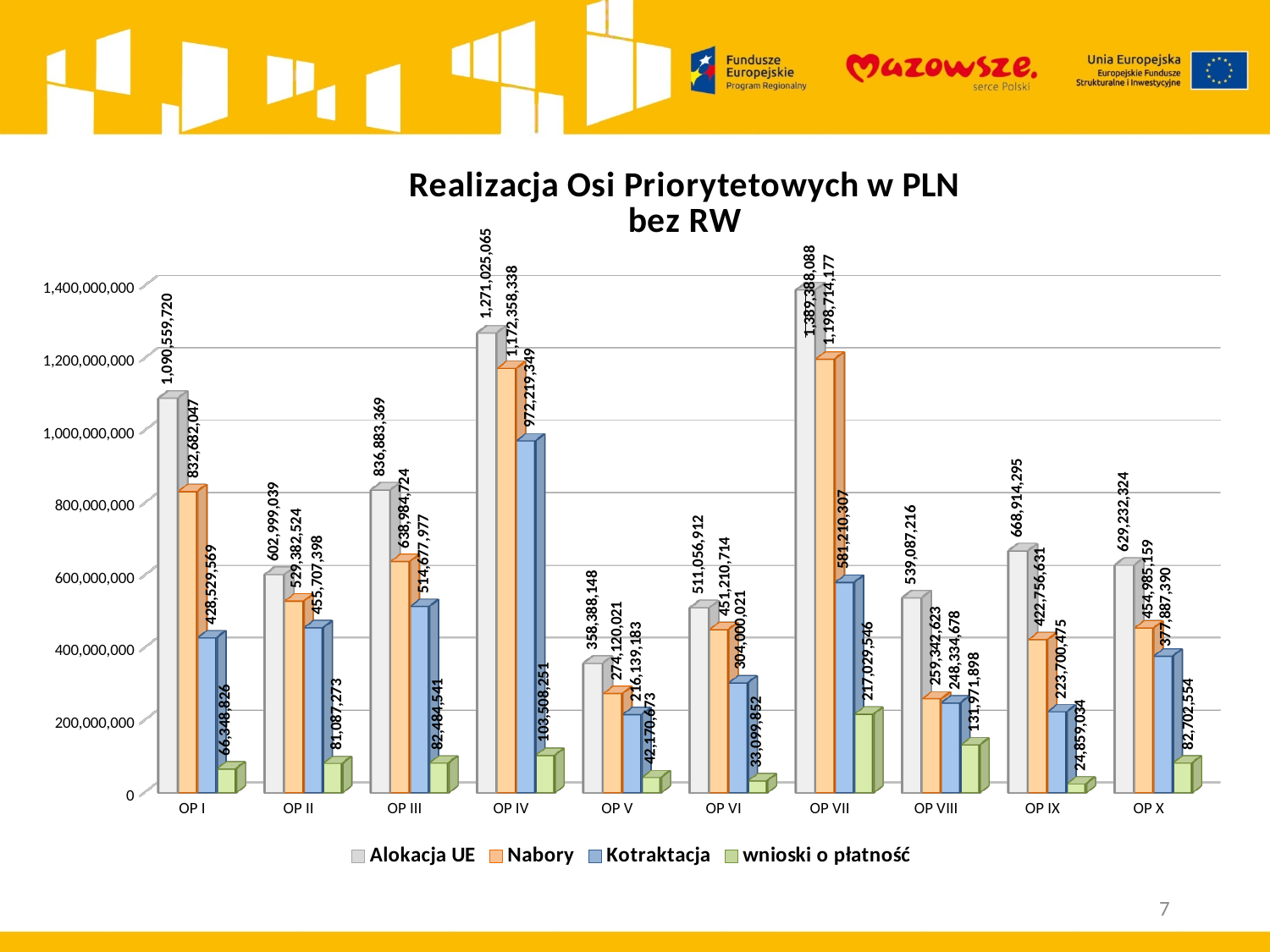
Is the Kotraktacja value for OP IV greater or less than 1,000,000,000? less What is the Nabory value for OP VI? 451,210,714 How many categories are shown on the x axis? 10 Which category has the lowest wnioski o płatność value? OP IX Which category has the highest Alokacja UE value? OP VII What is the title of the chart? Realizacja Osi Priorytetowych w PLN bez RW What kind of chart is shown on the slide? bar chart How many series does the legend list? 4 What is the wnioski o płatność value for OP VII? 217,029,546 What is the Alokacja UE value for OP IV? 1,271,025,065 Which has the larger Nabory value, OP III or OP X? OP III What is the difference between the Alokacja UE and Nabory values for OP II? 73,616,515